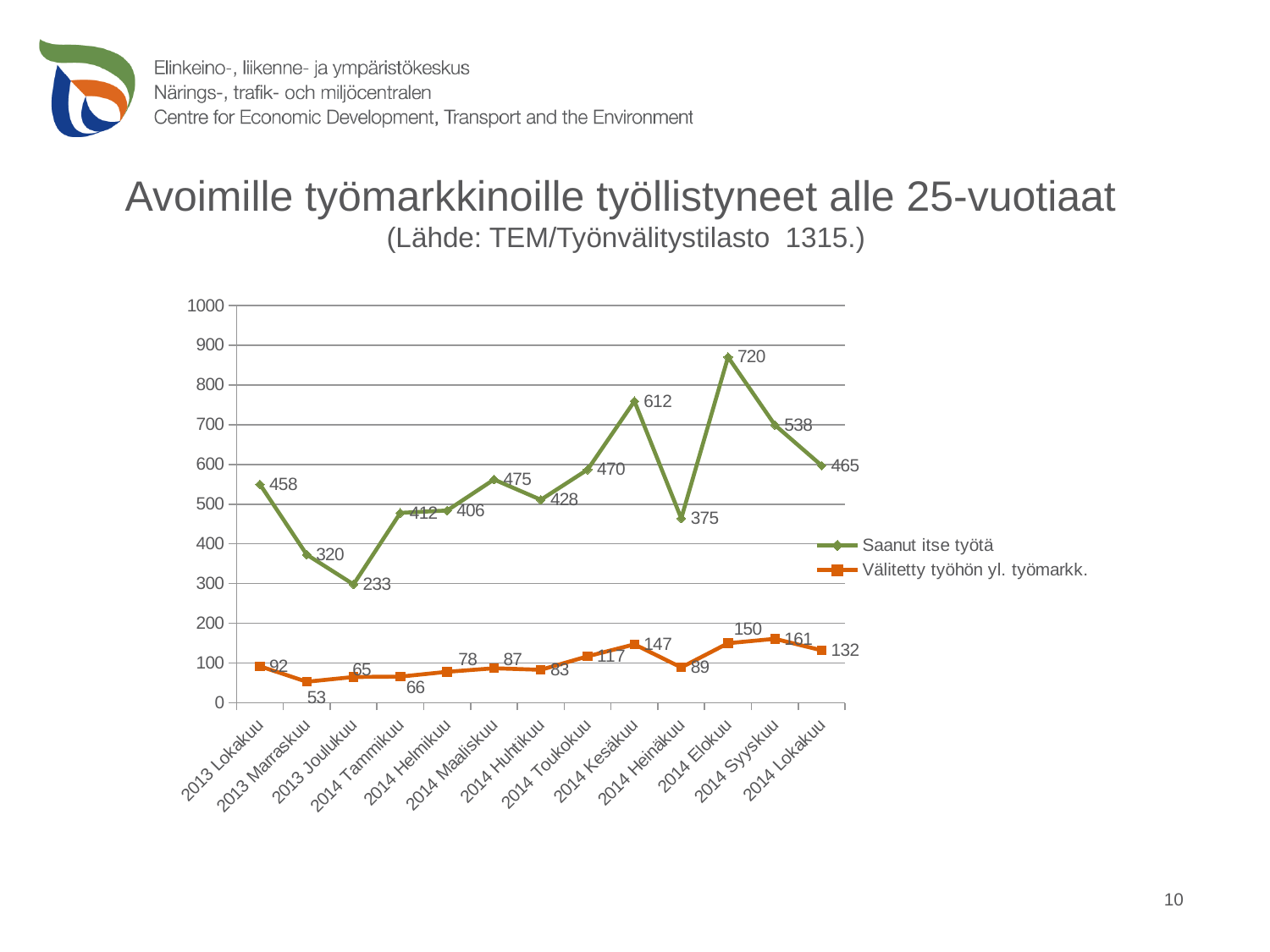
Which is larger for 2014 Lokakuu: 'Saanut itse työtä' or 'Välitetty työhön yl. työmarkk.'? Saanut itse työtä What is the value of 'Välitetty työhön yl. työmarkk.' for 2013 Marraskuu? 53 Does 'Saanut itse työtä' rise or fall from 2014 Syyskuu to 2014 Lokakuu? fall What colour is the line for 'Välitetty työhön yl. työmarkk.'? orange How many months are plotted along the x axis? 13 In which month is 'Välitetty työhön yl. työmarkk.' at its highest? 2014 Syyskuu What is the value of 'Saanut itse työtä' for 2014 Kesäkuu? 612 In which month is 'Saanut itse työtä' at its lowest? 2013 Joulukuu What type of chart is shown on the slide? line chart What is the value of 'Saanut itse työtä' for 2014 Elokuu? 720 What is the difference between 'Saanut itse työtä' in 2014 Elokuu and 2014 Heinäkuu? 345 How many series does the legend list? 2